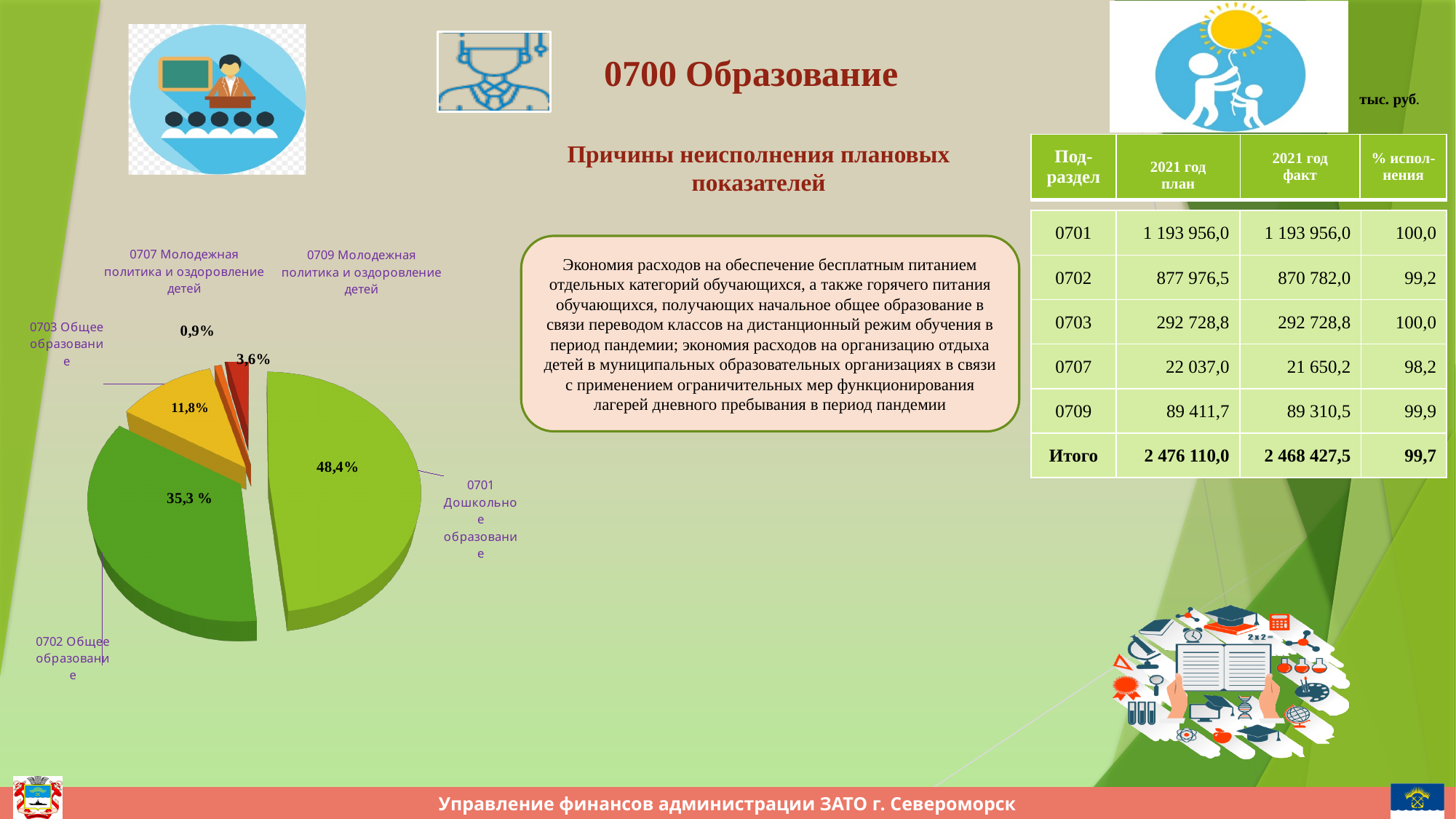
What share of the pie chart does 0707 Молодежная политика и оздоровление детей have? 0,9% What share of the pie chart does 0709 Молодежная политика и оздоровление детей have? 3,6% What is the title shown above the text box in the middle of the slide? Причины неисполнения плановых показателей What share of the pie chart does 0703 Общее образование have? 11,8% In the pie chart, which is larger: the share for 0702 Общее образование or the share for 0703 Общее образование? 0702 Общее образование Which slice of the pie chart is the smallest? 0707 Молодежная политика и оздоровление детей What is the difference in percentage points between the 0701 Дошкольное образование slice and the 0702 Общее образование slice? 13,1 What share of the pie chart does 0701 Дошкольное образование have? 48,4% Which slice of the pie chart is the largest? 0701 Дошкольное образование What share of the pie chart does 0702 Общее образование have? 35,3 % What kind of chart is shown on the left of the slide? pie chart How many slices does the pie chart have? 5